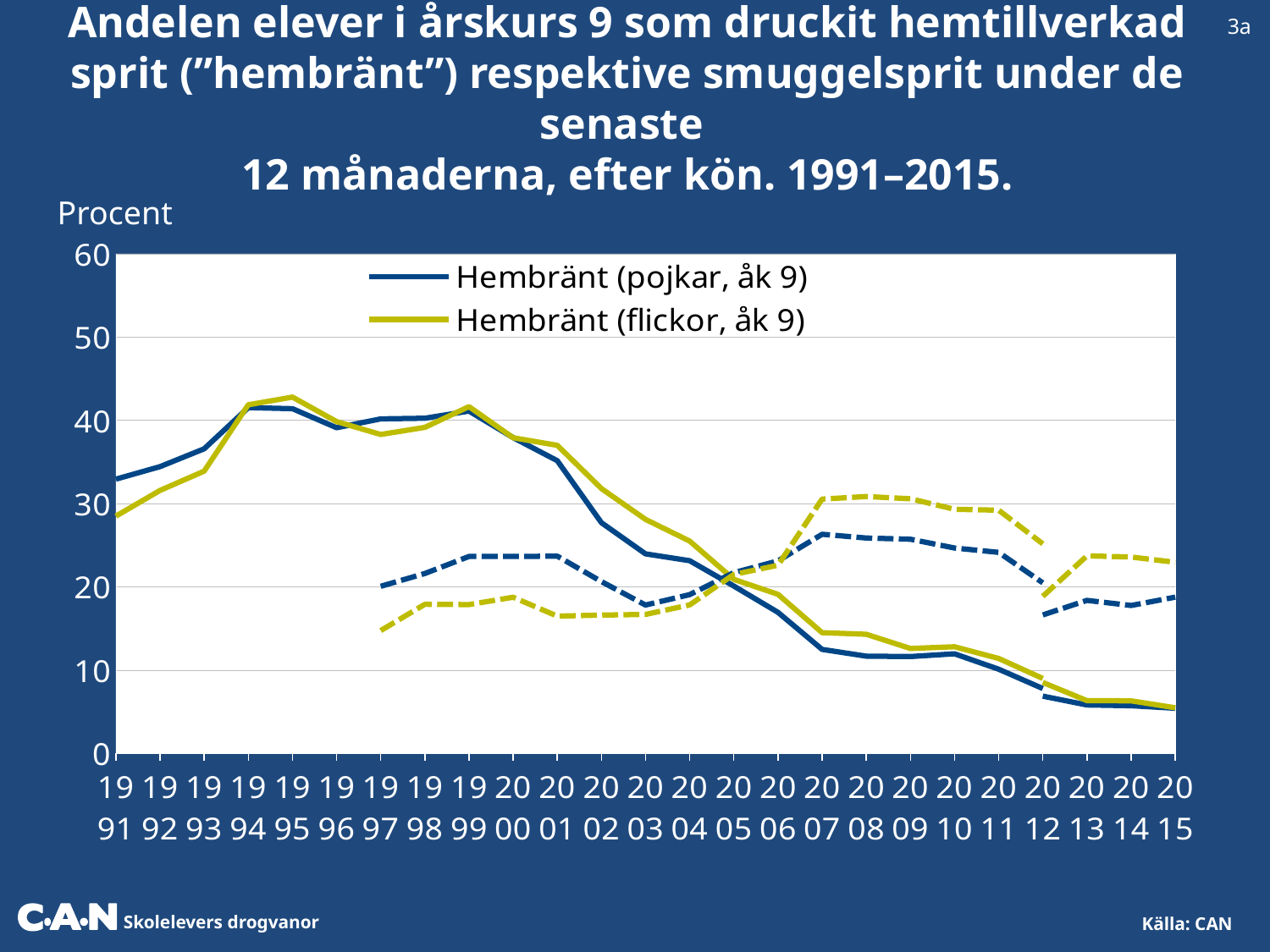
Is the value for Hembränt (pojkar, åk 9) in 1991 greater or less than 30? greater Does the Hembränt (pojkar, åk 9) series rise or fall between 1999 and 2015? fall How many series does the legend list? 2 Is the value for Hembränt (pojkar, åk 9) in 2015 greater or less than 10? less Which colour is used for the series Hembränt (flickor, åk 9)? yellow-green Is the value for Hembränt (flickor, åk 9) in 2007 greater or less than 20? less In 2003, which is higher: Hembränt (pojkar, åk 9) or Hembränt (flickor, åk 9)? Hembränt (flickor, åk 9) In 1991, which is higher: Hembränt (pojkar, åk 9) or Hembränt (flickor, åk 9)? Hembränt (pojkar, åk 9) What kind of chart is shown on the slide? line chart What is the label on the y axis? Procent How many years are shown along the x axis? 25